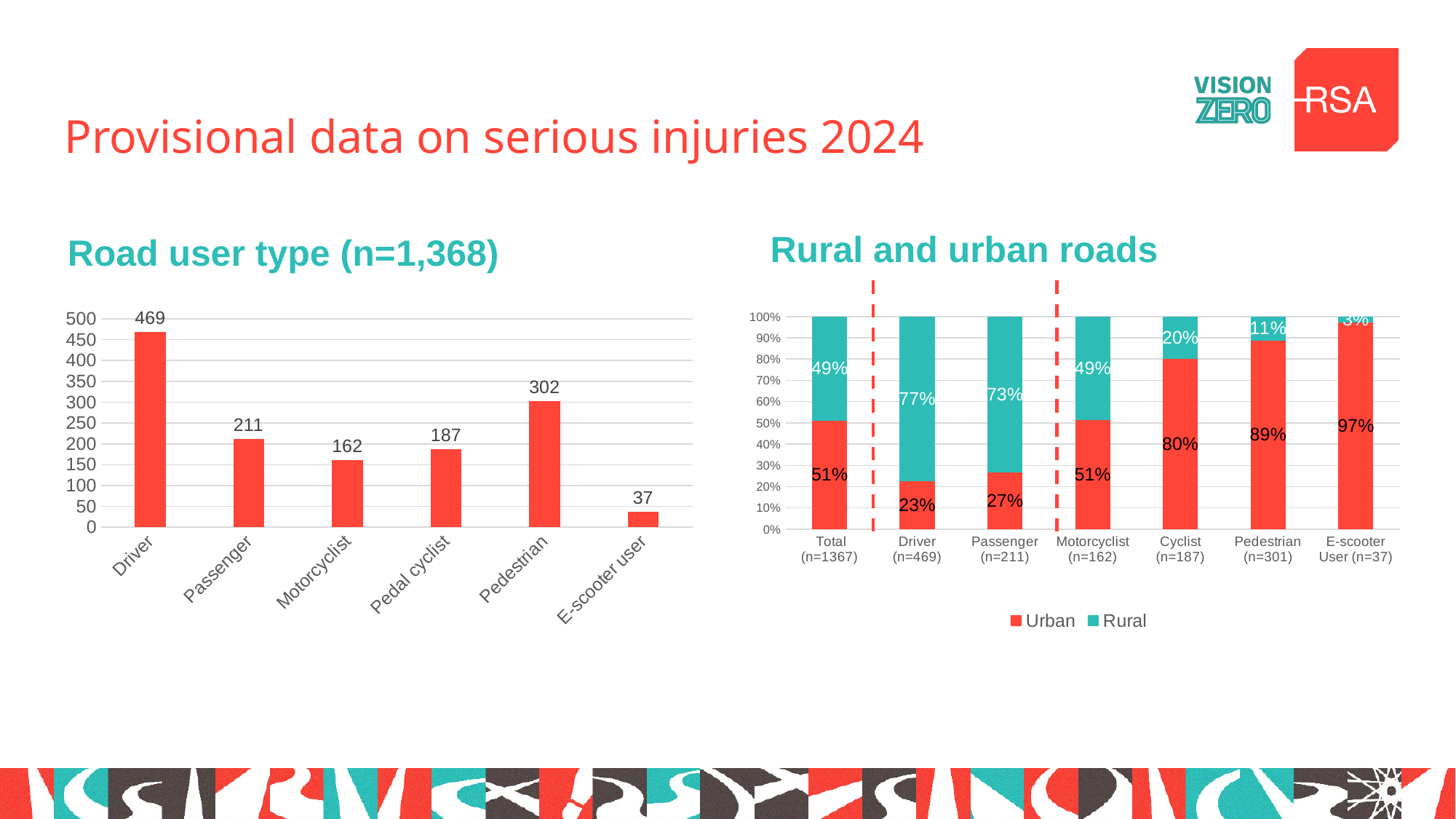
In the 'Road user type (n=1,368)' chart, how many road user categories are shown? 6 In the 'Rural and urban roads' chart, how many series does the legend list? 2 In the 'Road user type (n=1,368)' chart, which road user type has the lowest value? E-scooter user In the 'Road user type (n=1,368)' chart, what is the value for Driver? 469 In the 'Road user type (n=1,368)' chart, what is the value for Pedal cyclist? 187 In the 'Road user type (n=1,368)' chart, which is larger: Motorcyclist or Pedal cyclist? Pedal cyclist In the 'Rural and urban roads' chart, which category has the highest Urban percentage? E-scooter User (n=37) What kind of chart is the 'Rural and urban roads' chart? Stacked bar chart In the 'Road user type (n=1,368)' chart, which road user type has the highest value? Driver In the 'Road user type (n=1,368)' chart, what is the difference between the Pedestrian and Passenger values? 91 In the 'Rural and urban roads' chart, what is the Urban percentage for Driver (n=469)? 23% In the 'Rural and urban roads' chart, what is the Rural percentage for Cyclist (n=187)? 20%